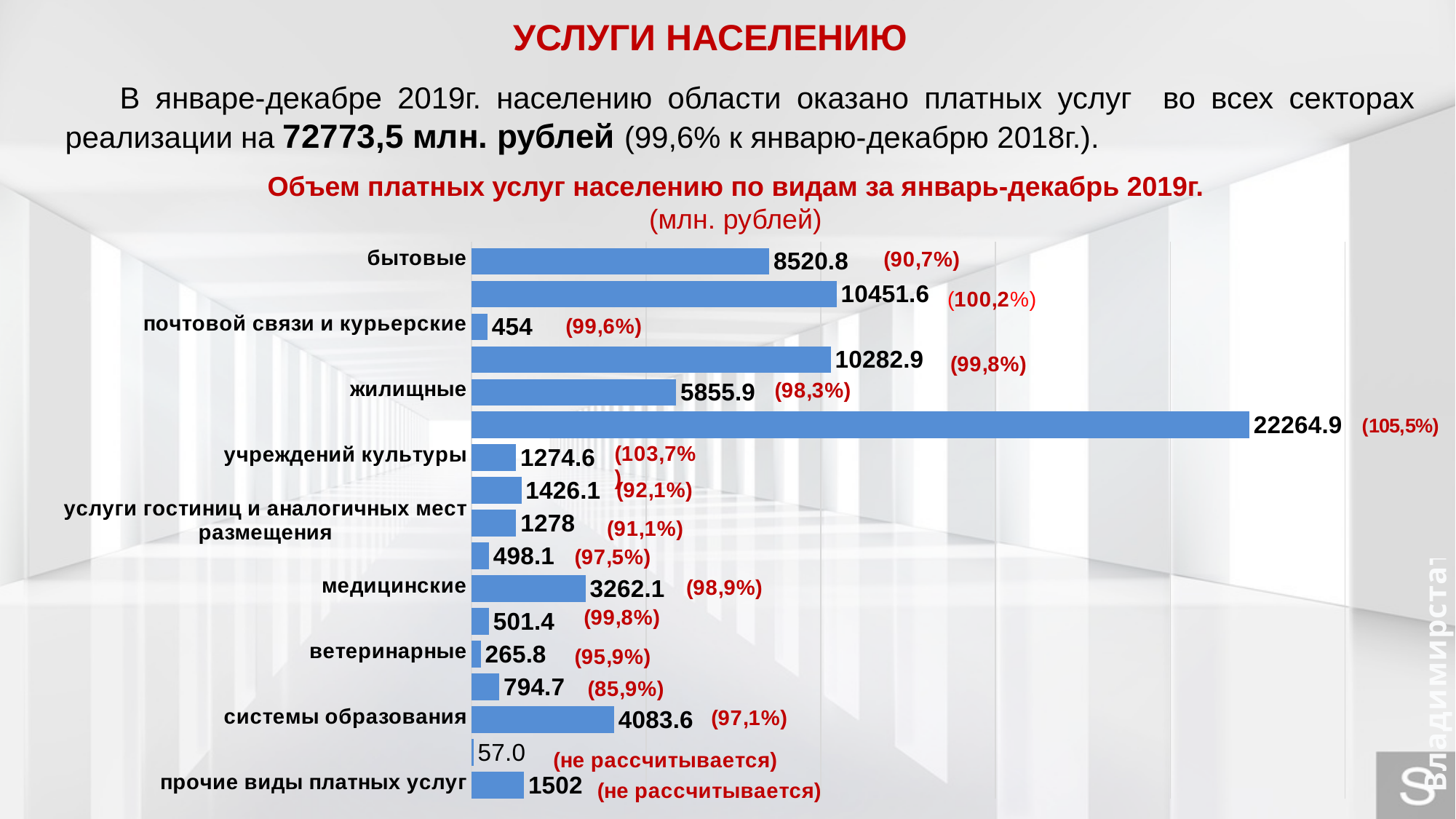
What is the value for бытовые services in the chart? 8520.8 Which is larger, the value for бытовые or for жилищные services? бытовые What is the value for почтовой связи и курьерские services in the chart? 454 What is the value for системы образования in the chart? 4083.6 What is the value for жилищные services in the chart? 5855.9 What is the value for ветеринарные services in the chart? 265.8 What percentage is shown in red next to the бытовые bar? (90,7%) How many bars are plotted in the chart? 17 What is the difference between the values for системы образования and медицинские services? 821.5 What is the largest value shown on any bar in the chart? 22264.9 What is the smallest value shown on any bar in the chart? 57.0 What is the value for медицинские services in the chart? 3262.1